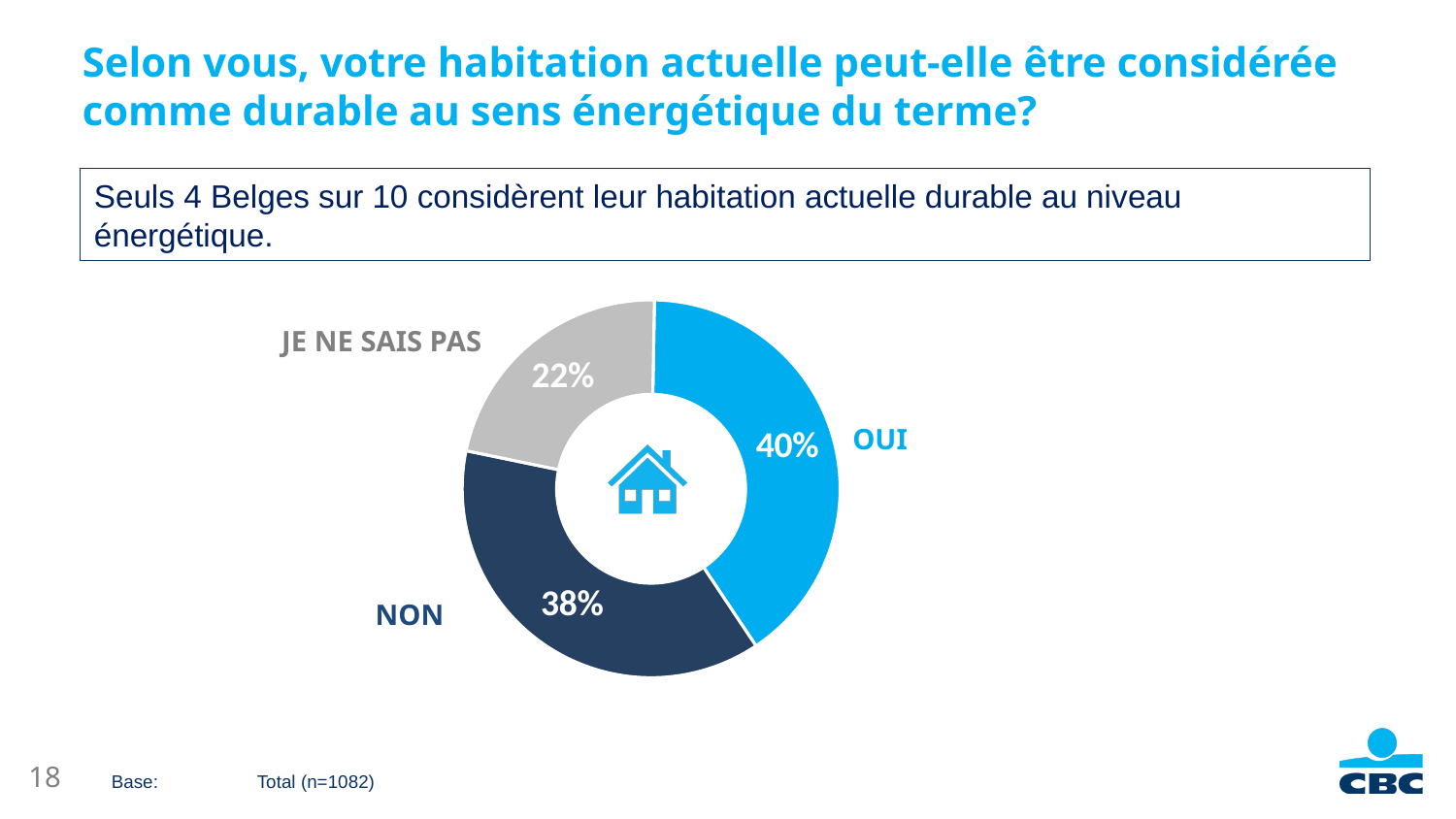
What percentage of respondents answered JE NE SAIS PAS? 22% Which is larger, the share for NON or the share for JE NE SAIS PAS? NON Which response has the largest share of the chart? OUI Which response has the smallest share of the chart? JE NE SAIS PAS What is the base (sample size) stated for the chart? Total (n=1082) What kind of chart is shown on the slide? Doughnut (pie) chart What percentage of respondents answered NON? 38% What percentage of respondents answered OUI? 40% What is the difference in percentage points between OUI and NON? 2 What colour is the OUI segment of the chart? Light blue How many response categories are shown in the chart? 3 What is the difference in percentage points between NON and JE NE SAIS PAS? 16